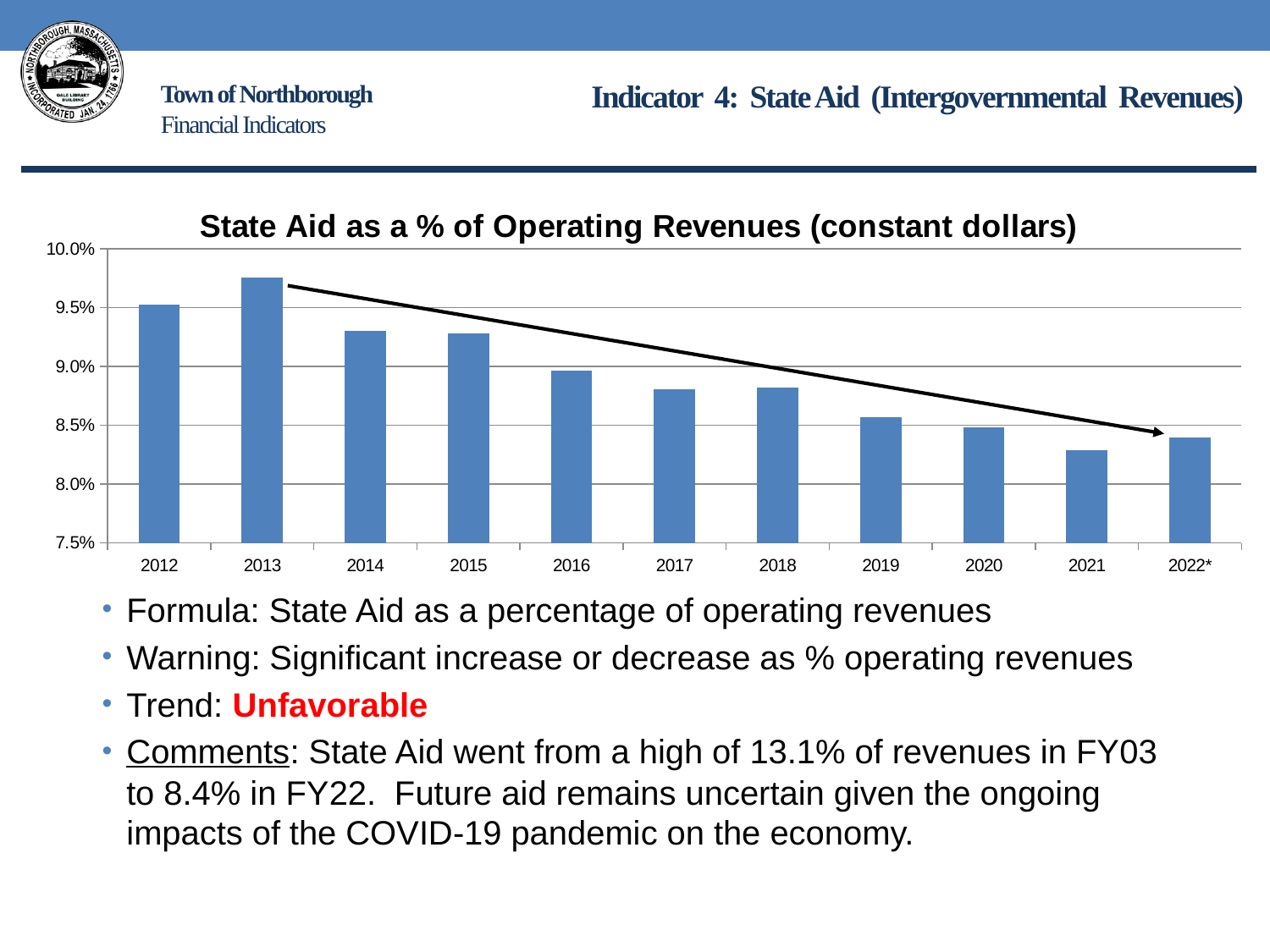
Is the value for 2021 greater or less than 8.5%? less Which year has the lowest State Aid as a % of Operating Revenues? 2021 Do the values generally rise or fall from 2012 to 2022*? Fall Is the value for 2014 greater or less than 9.0%? greater Which year has the highest State Aid as a % of Operating Revenues? 2013 Is the value for 2017 greater or less than 9.0%? less What is the title of the chart? State Aid as a % of Operating Revenues (constant dollars) Which is larger, the value for 2016 or the value for 2019? 2016 Which is larger, the value for 2012 or the value for 2014? 2012 What kind of chart is shown on the slide? Bar chart How many years are shown on the x axis of the chart? 11